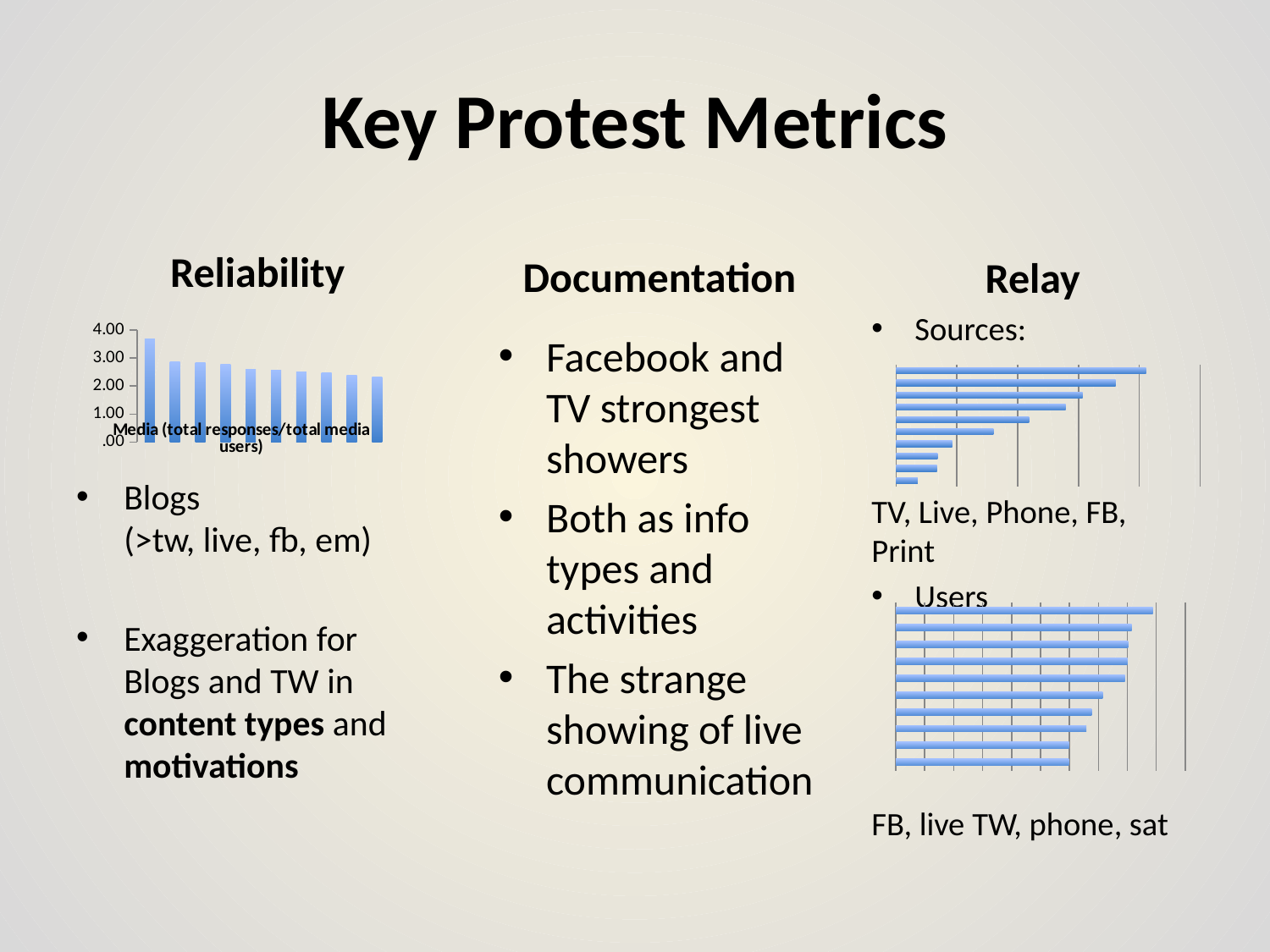
How many bars does the Reliability chart show? 10 In the Reliability chart, is the value of the leftmost bar greater or less than 3.00? greater What axis title is printed on the Reliability chart? Media (total responses/total media users) In the Reliability chart, is the value of the rightmost bar greater or less than 3.00? less What is the highest tick value on the vertical axis of the Reliability chart? 4.00 In the Reliability chart, do the bar values generally rise or fall from left to right? fall What kind of chart is the upper chart under the Relay heading (Sources)? bar chart In the Reliability chart, is the value of the second bar from the left greater or less than 2.00? greater In the upper Relay chart (Sources), do the bar lengths increase or decrease from top to bottom? decrease What kind of chart is shown under the Reliability heading? bar chart In the Reliability chart, is the leftmost bar taller or shorter than the rightmost bar? taller In the lower Relay chart (Users), is the top bar longer or shorter than the bottom bar? longer